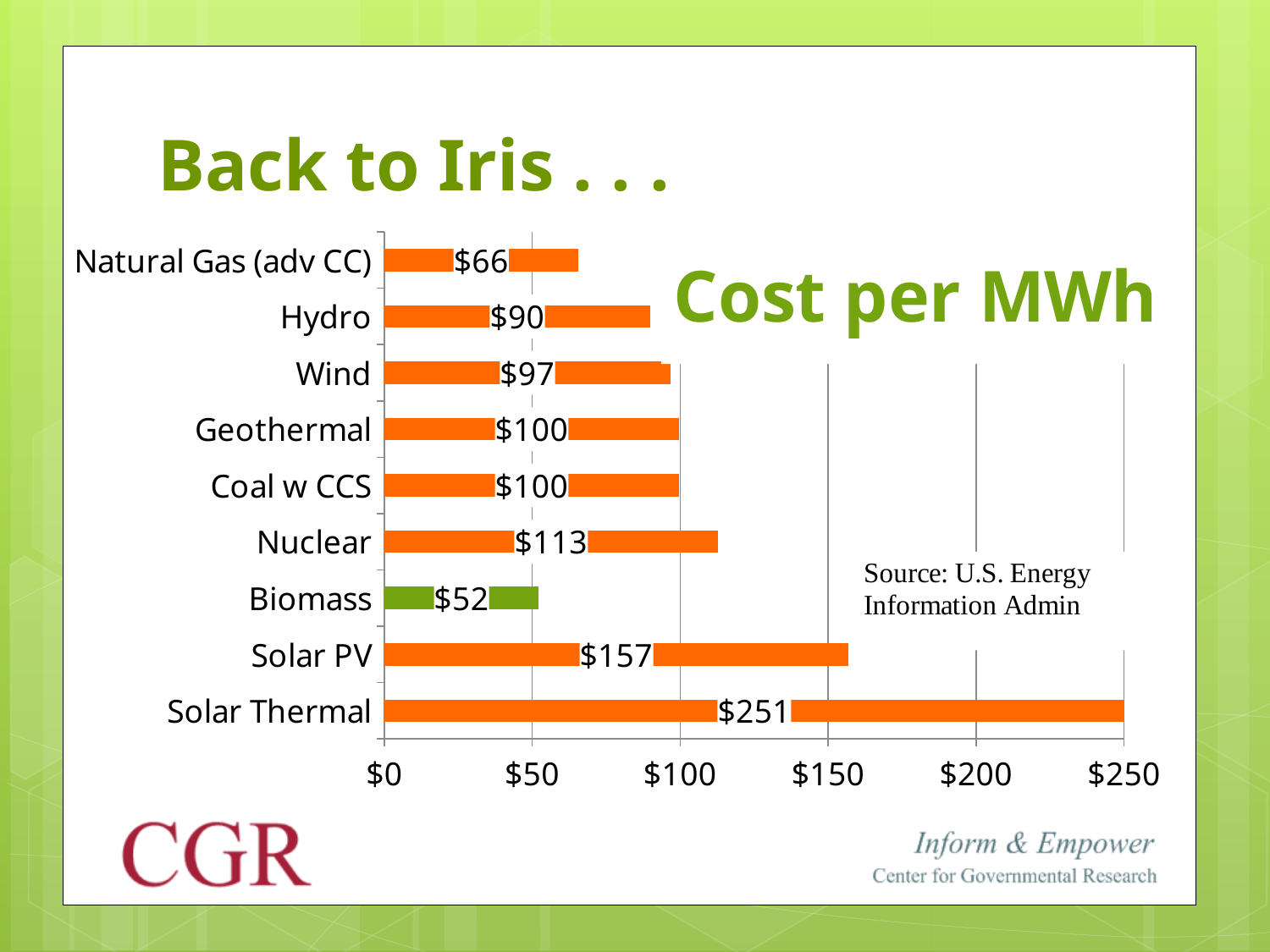
Is the cost per MWh for Solar PV greater or less than $150? greater What is the cost per MWh for Solar PV? $157 Which bar in the chart is coloured green rather than orange? Biomass Which has a higher cost per MWh, Wind or Nuclear? Nuclear What is the cost per MWh for Biomass? $52 How many energy sources are shown in the chart? 9 What is the cost per MWh for Nuclear? $113 What is the difference in cost per MWh between Hydro and Natural Gas (adv CC)? $24 What type of chart is shown on the slide? Bar chart Which energy source has the highest cost per MWh? Solar Thermal What is the difference in cost per MWh between Solar Thermal and Solar PV? $94 Which energy source has the lowest cost per MWh? Biomass